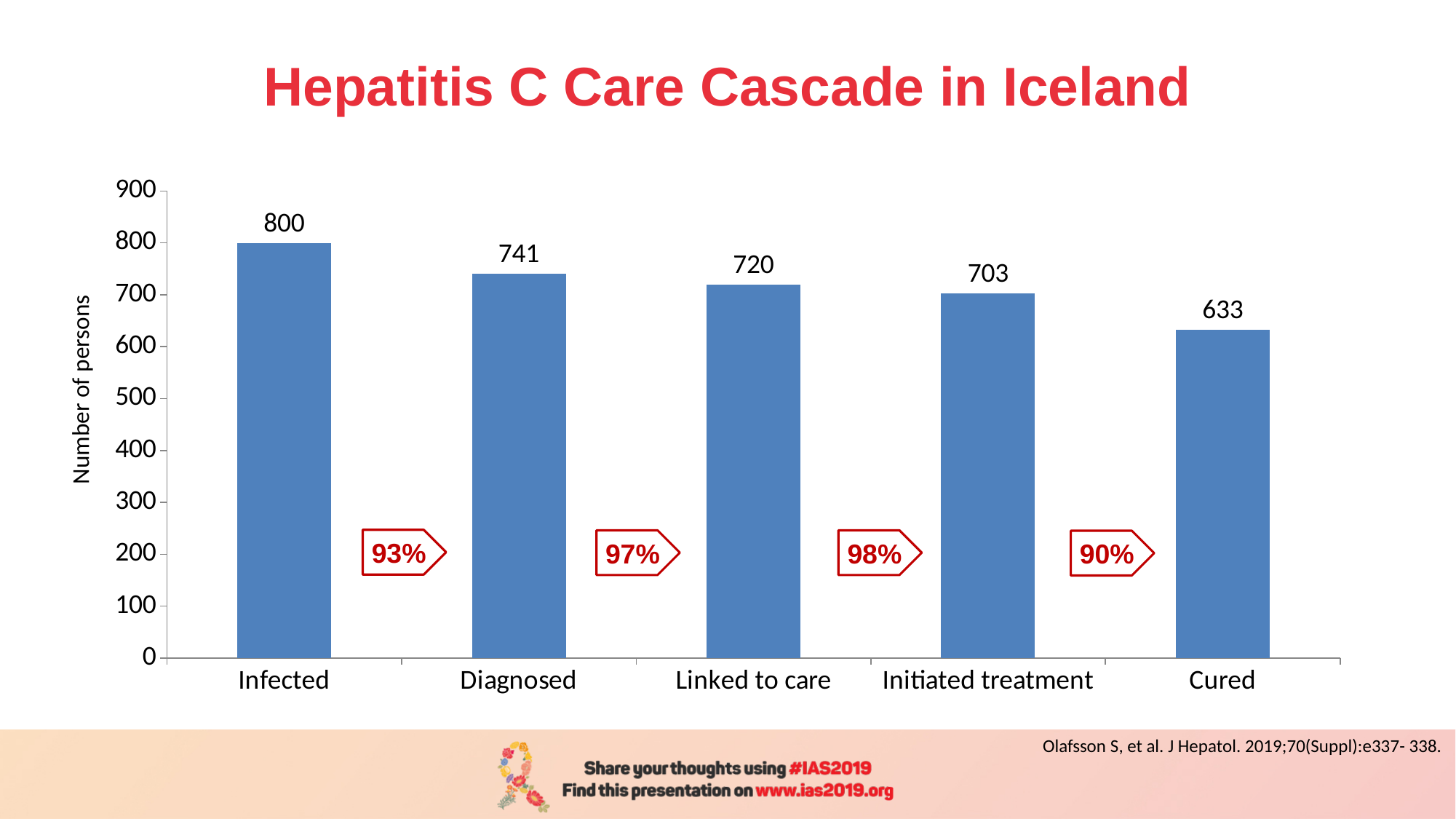
Is the value for Cured greater or less than 700? less How many categories are shown on the x axis? 5 Do the values rise or fall from Infected to Cured along the x axis? fall What is the number of persons for the Diagnosed category? 741 Which category has the lowest number of persons? Cured What is the number of persons for the Cured category? 633 What is the difference in number of persons between Linked to care and Initiated treatment? 17 What kind of chart is shown on the slide? bar chart Which has more persons, Diagnosed or Initiated treatment? Diagnosed Which category has the highest number of persons? Infected What is the difference in number of persons between Infected and Cured? 167 What is the number of persons for the Infected category? 800